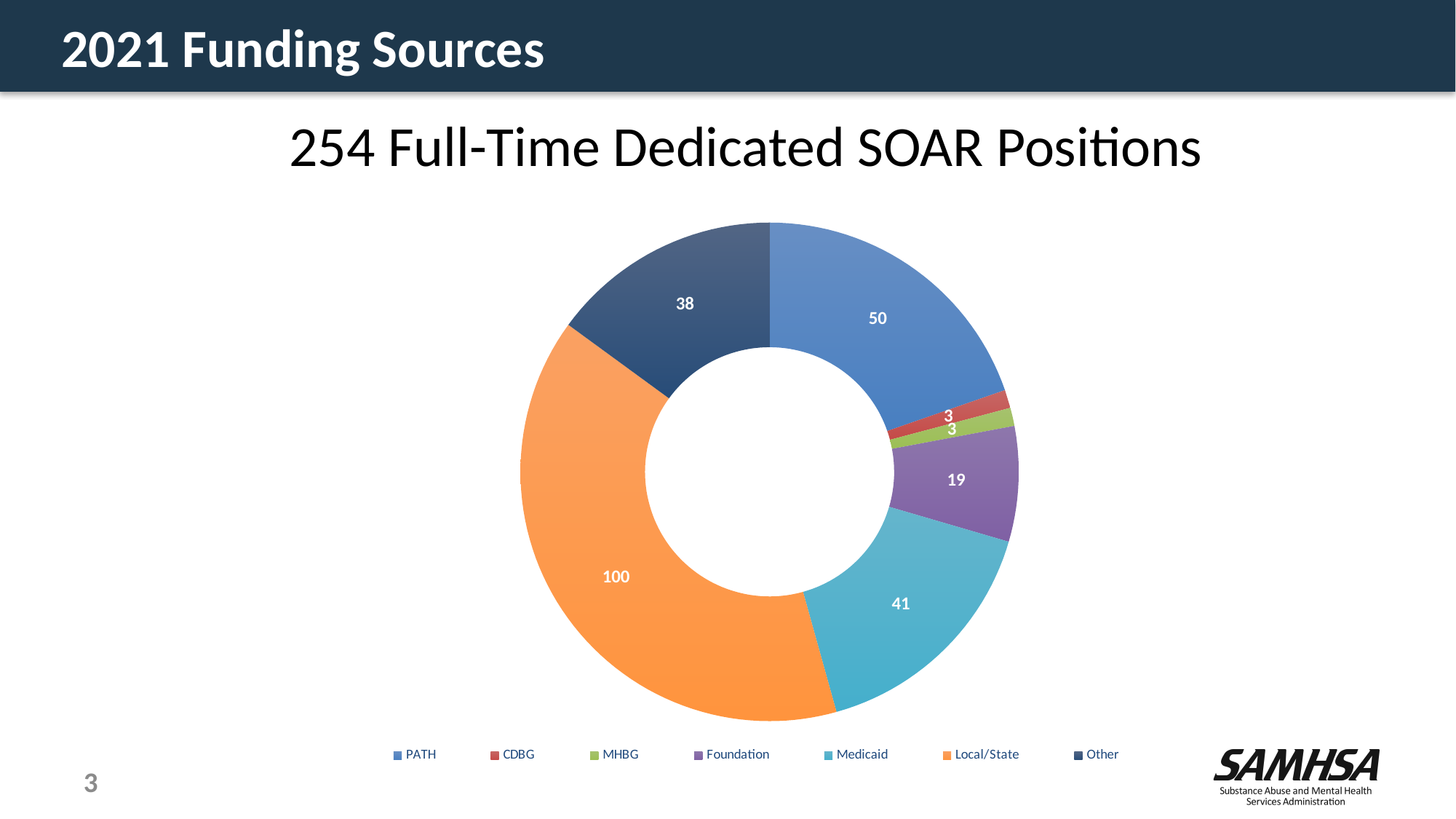
What is the total of all the slices in the chart? 254 What value is shown for Medicaid? 41 Which funding source has the largest slice? Local/State What value is shown for Local/State? 100 What is the difference between the Local/State value and the PATH value? 50 What value is shown for Foundation? 19 What value is shown for Other? 38 What kind of chart is shown on the slide? doughnut chart What colour is the Local/State slice? orange How many funding sources does the legend list? 7 Which is larger, the value for PATH or the value for Medicaid? PATH What is the difference between the Medicaid value and the Other value? 3